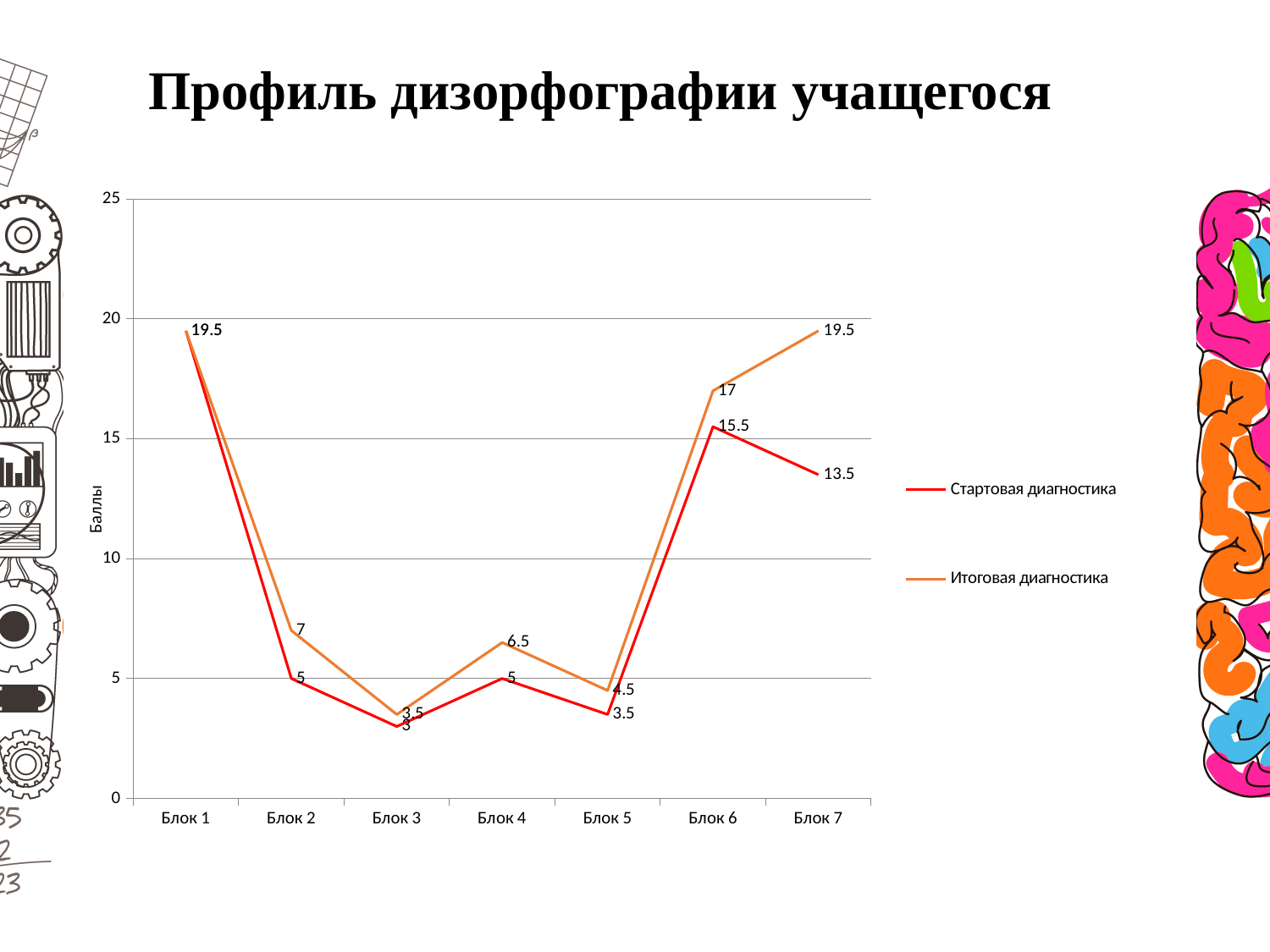
How many blocks (categories) are plotted along the x axis? 7 Is the Стартовая диагностика value for Блок 7 greater or less than 15? less How many series does the legend list? 2 What is the value of Итоговая диагностика for Блок 7? 19.5 What is the difference between Итоговая диагностика and Стартовая диагностика for Блок 6? 1.5 What is the value of Итоговая диагностика for Блок 4? 6.5 What is the difference between Итоговая диагностика and Стартовая диагностика for Блок 7? 6 What kind of chart is shown on the slide? line chart For which block is the Стартовая диагностика value lowest? Блок 3 What is the title of the vertical axis? Баллы For Блок 2, which series has the larger value, Стартовая диагностика or Итоговая диагностика? Итоговая диагностика What is the value of Стартовая диагностика for Блок 6? 15.5